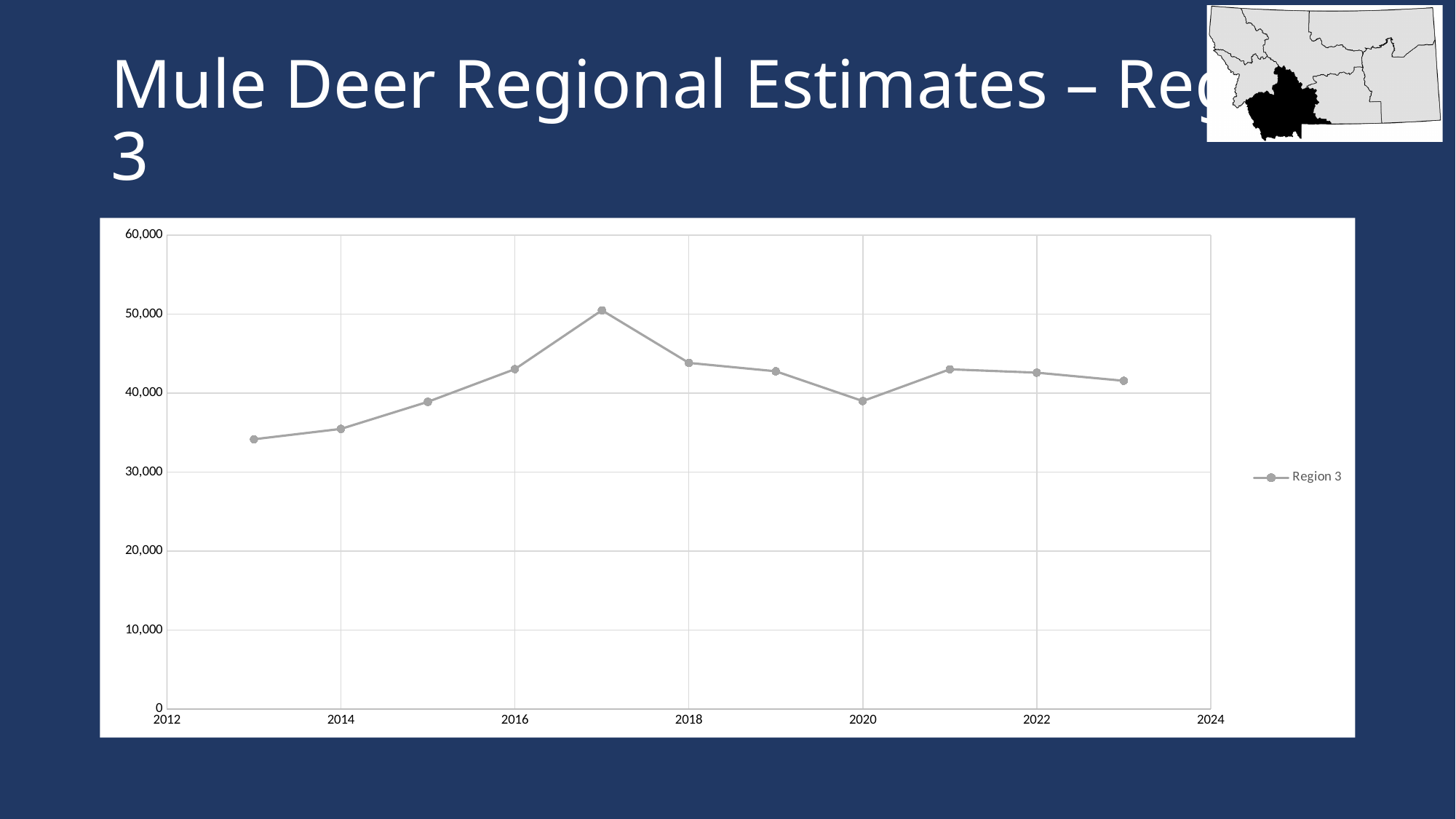
Do the Region 3 values rise or fall from 2013 to 2017? rise Is the value for 2016 greater or less than 40,000? greater In which year is the Region 3 estimate lowest? 2013 What is the name of the series shown in the legend? Region 3 Which year has the larger Region 3 estimate, 2018 or 2020? 2018 Is the value for 2013 greater or less than 40,000? less Which year has the larger Region 3 estimate, 2014 or 2016? 2016 How many data points are plotted on the Region 3 line? 11 What kind of chart is shown on the slide? line chart How many series does the legend list? 1 Is the value for 2017 greater or less than 40,000? greater In which year is the Region 3 estimate highest? 2017